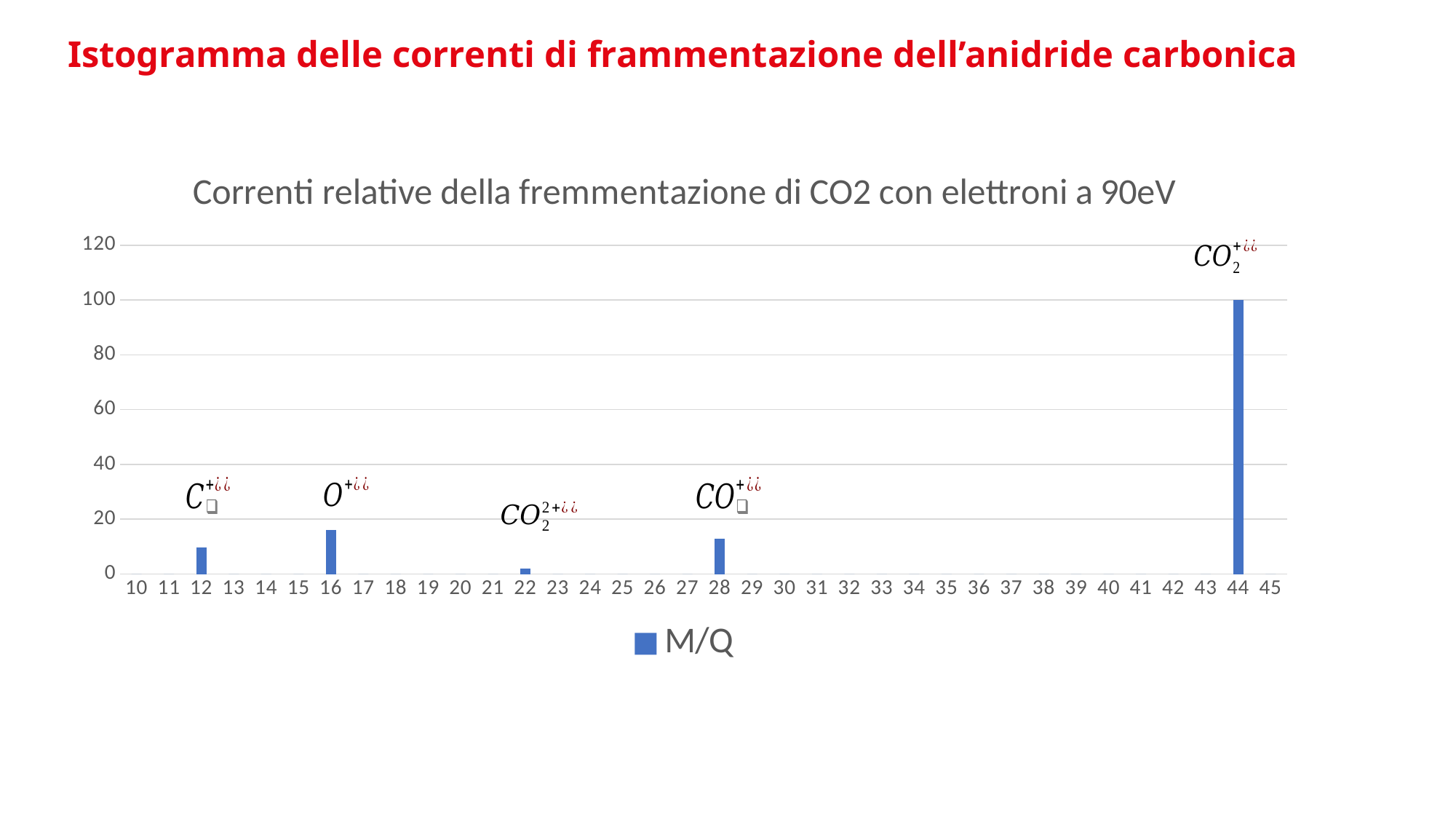
Is the value for M/Q 28 greater or less than 20? less Is the value for M/Q 12 greater or less than 20? less Among the bars that are visible, which M/Q value has the smallest bar? 22 What is the legend entry of the chart? M/Q Which is larger, the bar at M/Q 16 or the bar at M/Q 12? M/Q 16 How many bars with a visible non-zero height are plotted? 5 Which is larger, the bar at M/Q 28 or the bar at M/Q 22? M/Q 28 What kind of chart is shown on the slide? bar chart What is the value of the bar at M/Q 44? 100 How many series does the legend list? 1 Which M/Q value has the highest bar? 44 Is the value for M/Q 44 greater or less than 80? greater